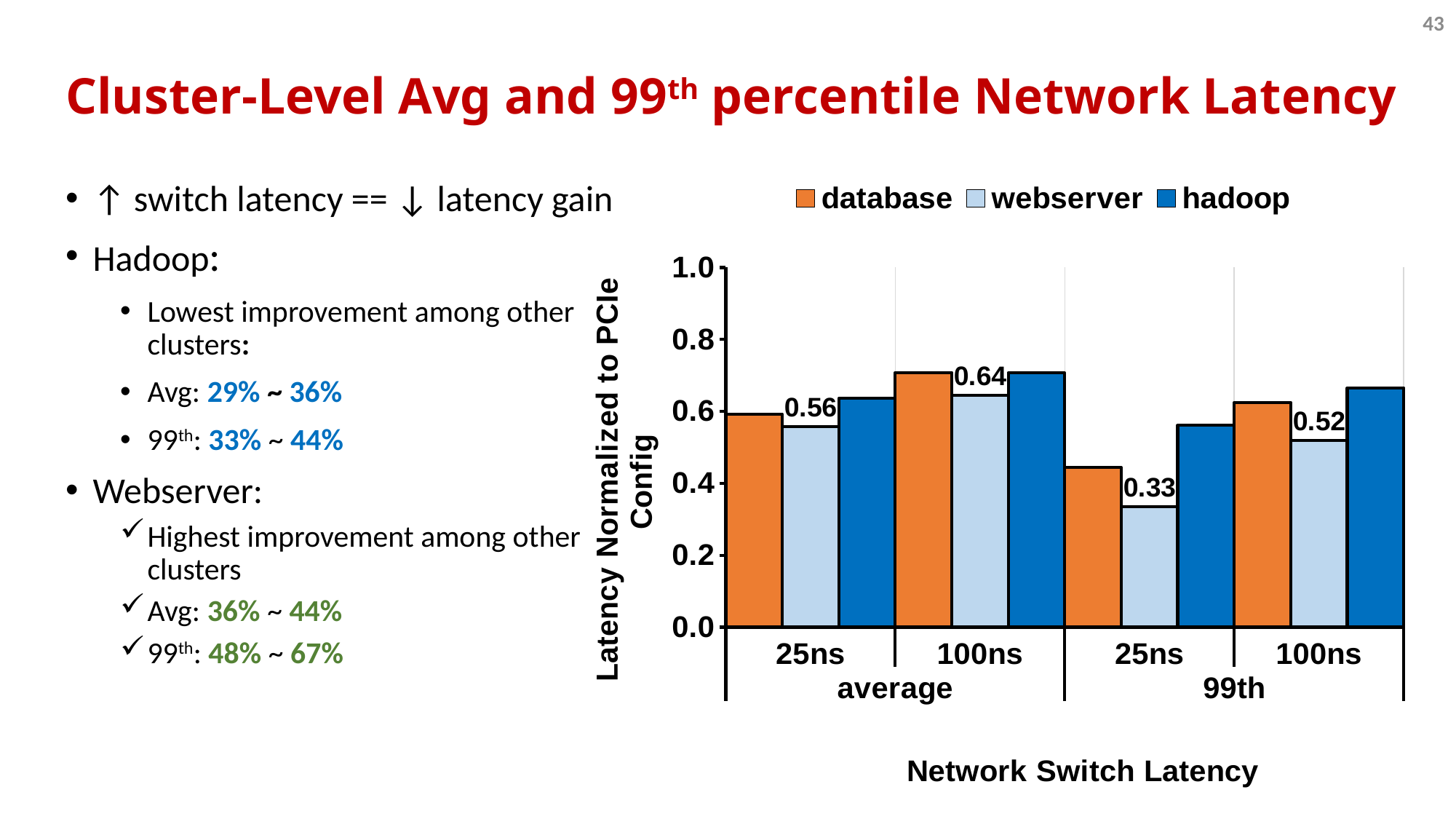
Is the hadoop value at 100ns under average greater or less than 0.6? greater At 25ns under 99th, which is larger: database or webserver? database What is the webserver value at 25ns under 99th? 0.33 Which group has the highest labeled webserver value? 100ns under average How many series does the legend list? 3 What is the webserver value at 100ns under 99th? 0.52 What is the y-axis title of the chart? Latency Normalized to PCIe Config What is the difference between the webserver values at 100ns and 25ns under average? 0.08 What is the webserver value at 25ns under average? 0.56 Which group has the lowest labeled webserver value? 25ns under 99th Is the database value at 25ns under 99th greater or less than 0.6? less What is the difference between the webserver values at 100ns and 25ns under 99th? 0.19